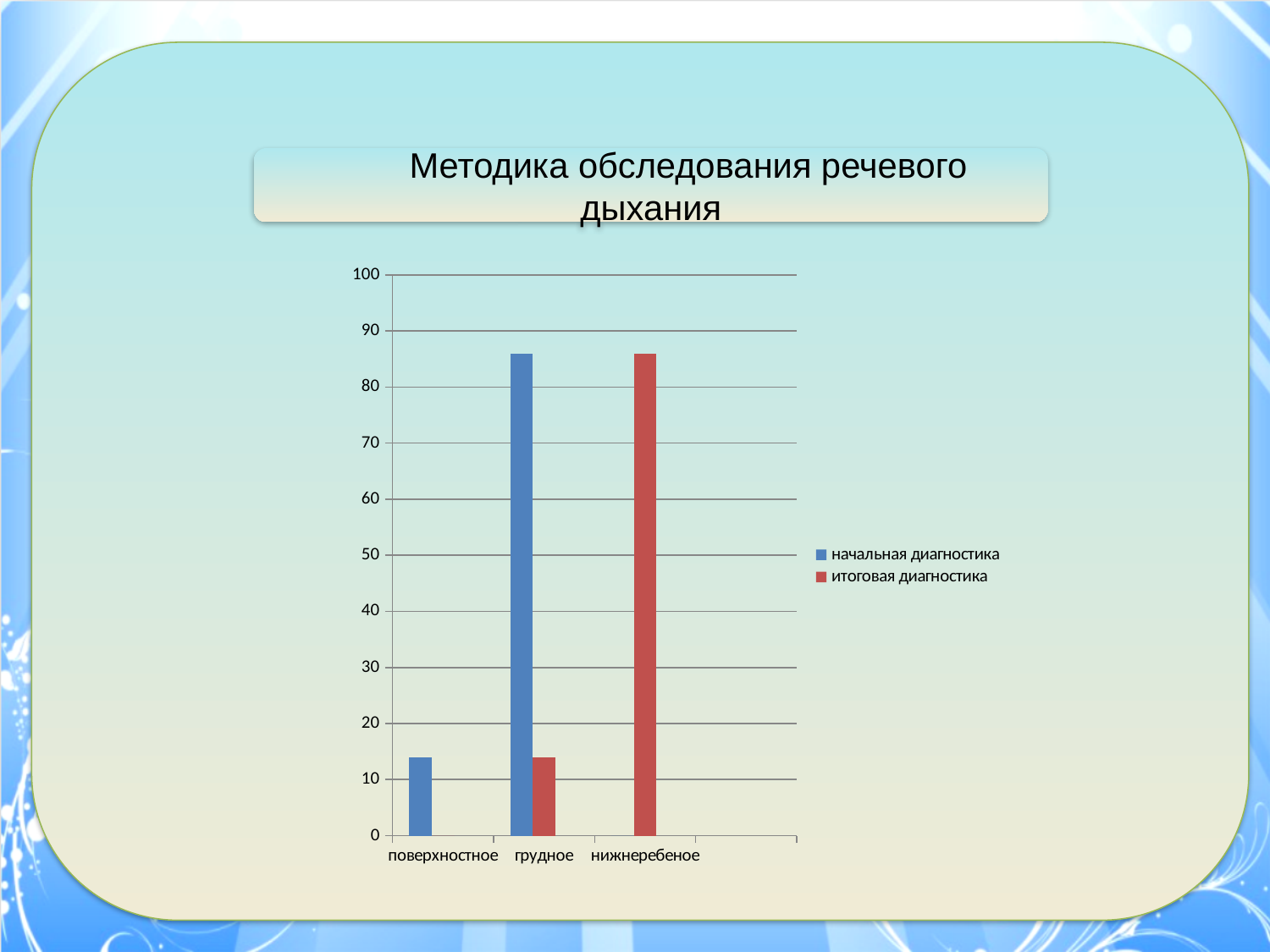
Which category has the highest value for начальная диагностика? грудное What is the title shown above the chart? Методика обследования речевого дыхания Which category has no visible bar for итоговая диагностика? поверхностное Is the value for начальная диагностика in the грудное category greater or less than 80? greater Which category has the highest value for итоговая диагностика? нижнеребеное Is the value for итоговая диагностика in the нижнеребеное category greater or less than 80? greater In the грудное category, which series has the larger value: начальная диагностика or итоговая диагностика? начальная диагностика How many categories are shown on the x axis? 3 How many series does the legend list? 2 Is the value for начальная диагностика in the поверхностное category greater or less than 20? less What kind of chart is shown on the slide? bar chart